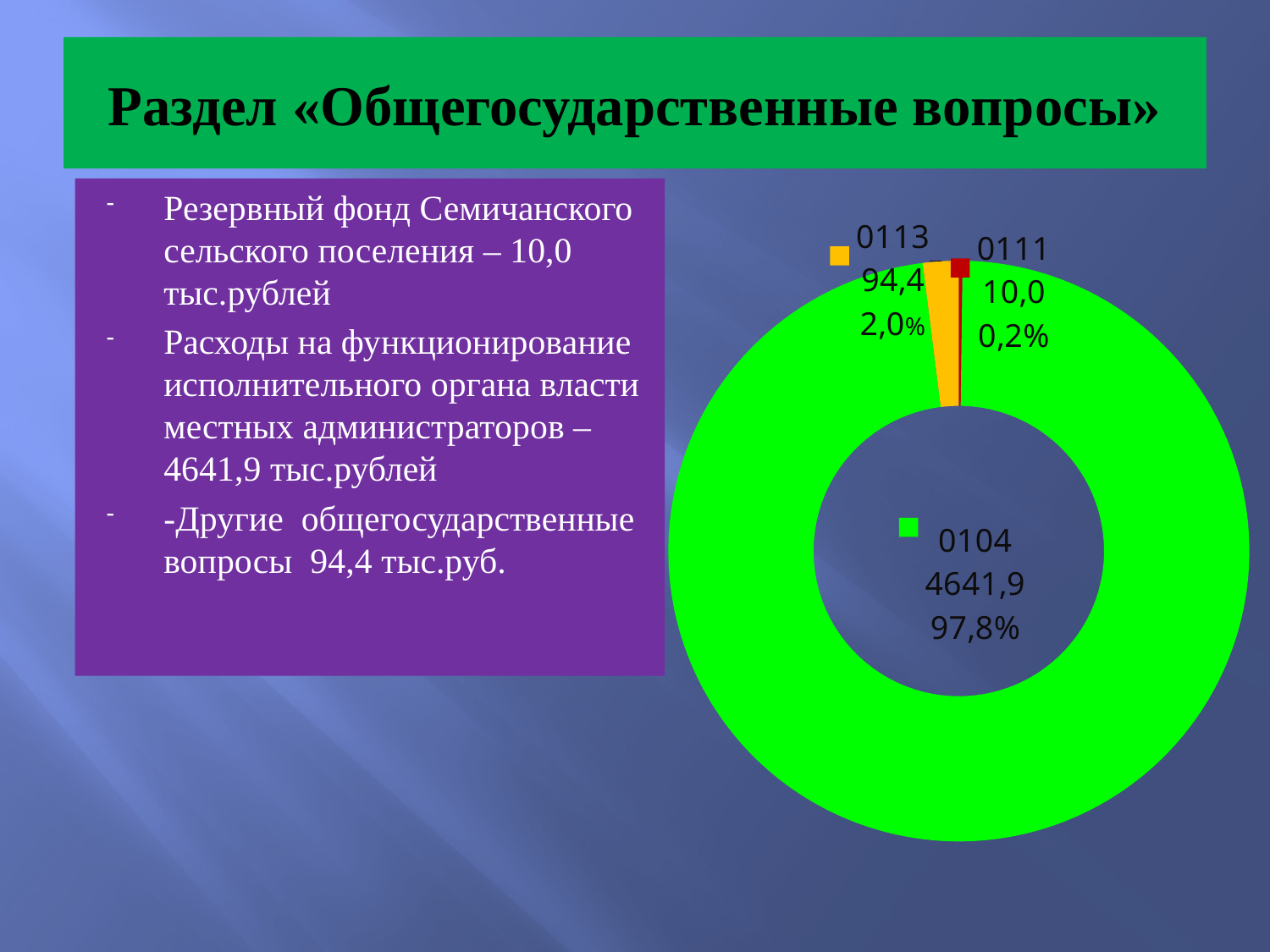
Which is larger, slice 0113 or slice 0111? 0113 What share of the chart does slice 0104 represent? 97,8% What is the value shown for slice 0113? 94,4 What is the difference between the values of slice 0113 and slice 0111? 84,4 How many slices does the chart have? 3 Which slice is the largest? 0104 What share of the chart does slice 0113 represent? 2,0% What share of the chart does slice 0111 represent? 0,2% What kind of chart is shown on the slide? doughnut chart What is the value shown for slice 0111? 10,0 Which slice is the smallest? 0111 What is the value shown for slice 0104? 4641,9